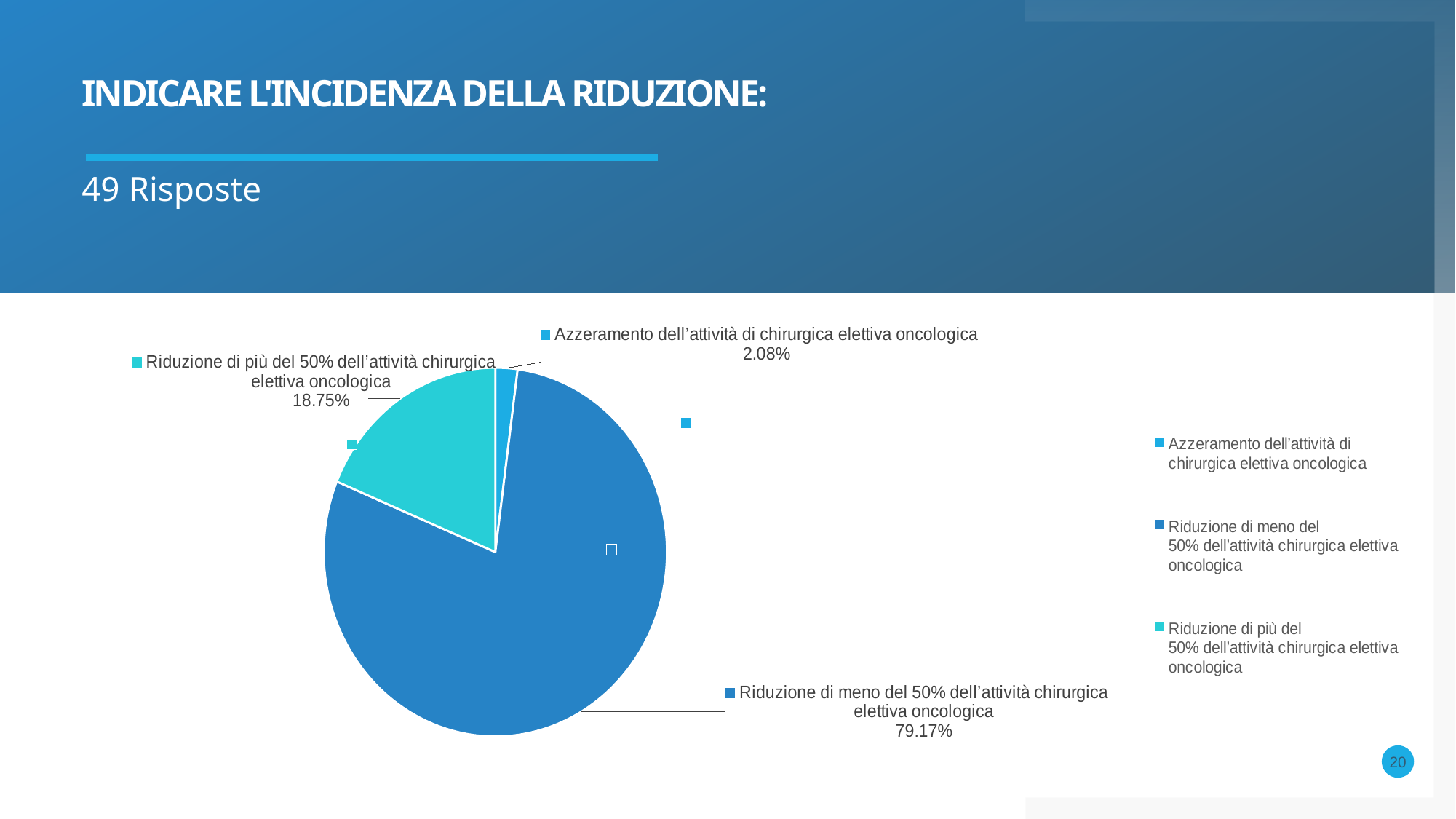
What share of the pie does "Azzeramento dell'attività di chirurgica elettiva oncologica" represent? 2.08% Which category has the largest slice of the pie? Riduzione di meno del 50% dell'attività chirurgica elettiva oncologica What is the difference in percentage points between the "Riduzione di più del 50%" slice and the "Azzeramento" slice? 16.67 Which is larger: the "Riduzione di più del 50%" slice or the "Azzeramento" slice? Riduzione di più del 50% dell'attività chirurgica elettiva oncologica Which category has the smallest slice of the pie? Azzeramento dell'attività di chirurgica elettiva oncologica How many responses does the slide say the chart is based on? 49 How many entries does the legend list? 3 How many categories are shown in the pie chart? 3 What share of the pie does "Riduzione di più del 50% dell'attività chirurgica elettiva oncologica" represent? 18.75% What share of the pie does "Riduzione di meno del 50% dell'attività chirurgica elettiva oncologica" represent? 79.17% What kind of chart is shown on the slide? Pie chart What is the difference in percentage points between the "Riduzione di meno del 50%" slice and the "Riduzione di più del 50%" slice? 60.42